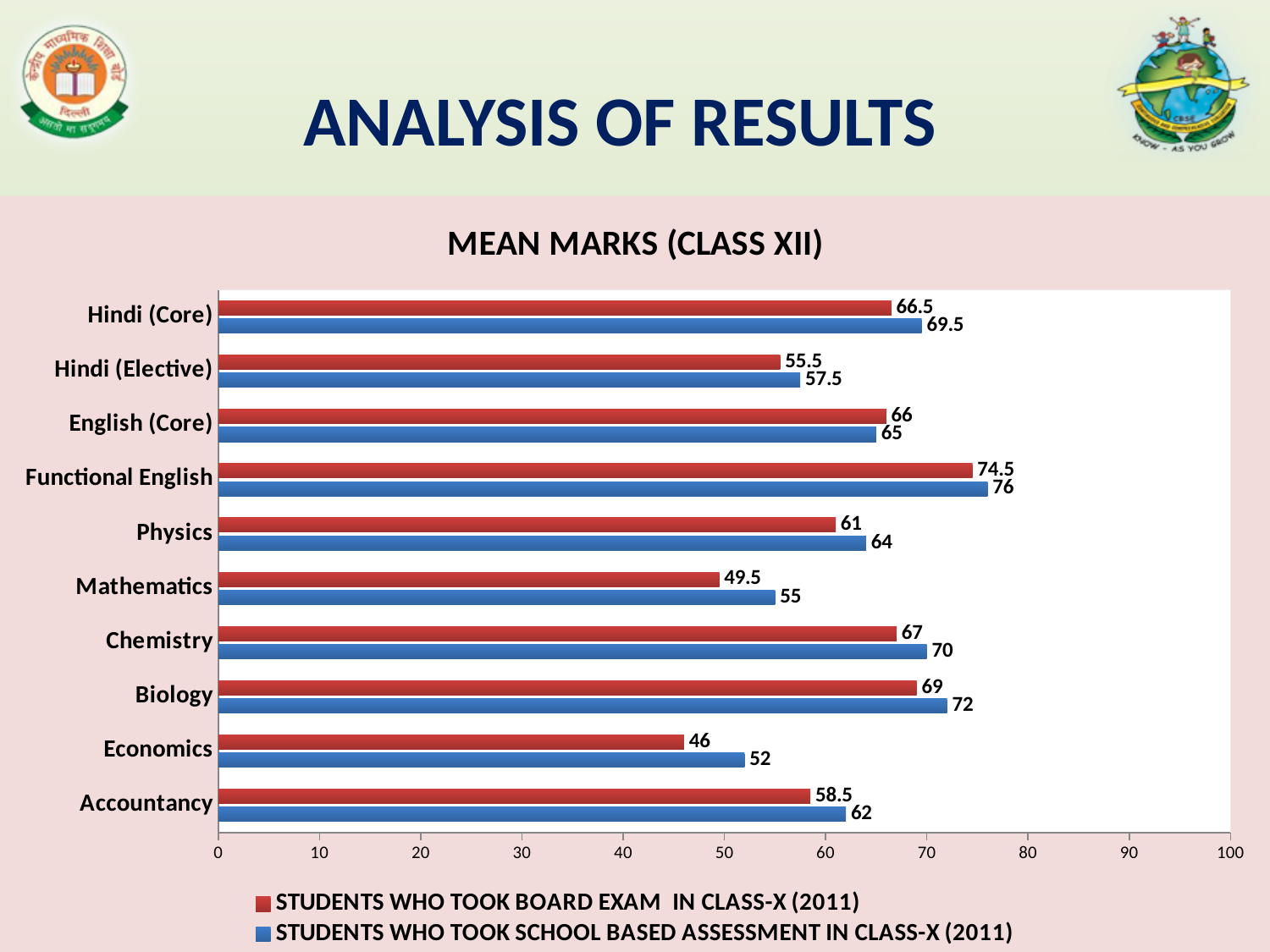
What is the difference between the school based assessment and board exam mean marks in Economics? 6 How many subjects are shown on the chart? 10 What is the difference between the school based assessment and board exam mean marks in Mathematics? 5.5 What is the mean mark in Mathematics for students who took the board exam in Class-X (2011)? 49.5 What is the title of the chart? MEAN MARKS (CLASS XII) Which subject has the highest mean mark for students who took school based assessment in Class-X (2011)? Functional English How many series does the legend list? 2 What is the mean mark in Functional English for students who took school based assessment in Class-X (2011)? 76 What is the mean mark in Biology for students who took the board exam in Class-X (2011)? 69 What kind of chart is shown on the slide? Bar chart In English (Core), which group has the higher mean mark: students who took the board exam or students who took school based assessment? Students who took board exam Which subject has the lowest mean mark for students who took the board exam in Class-X (2011)? Economics